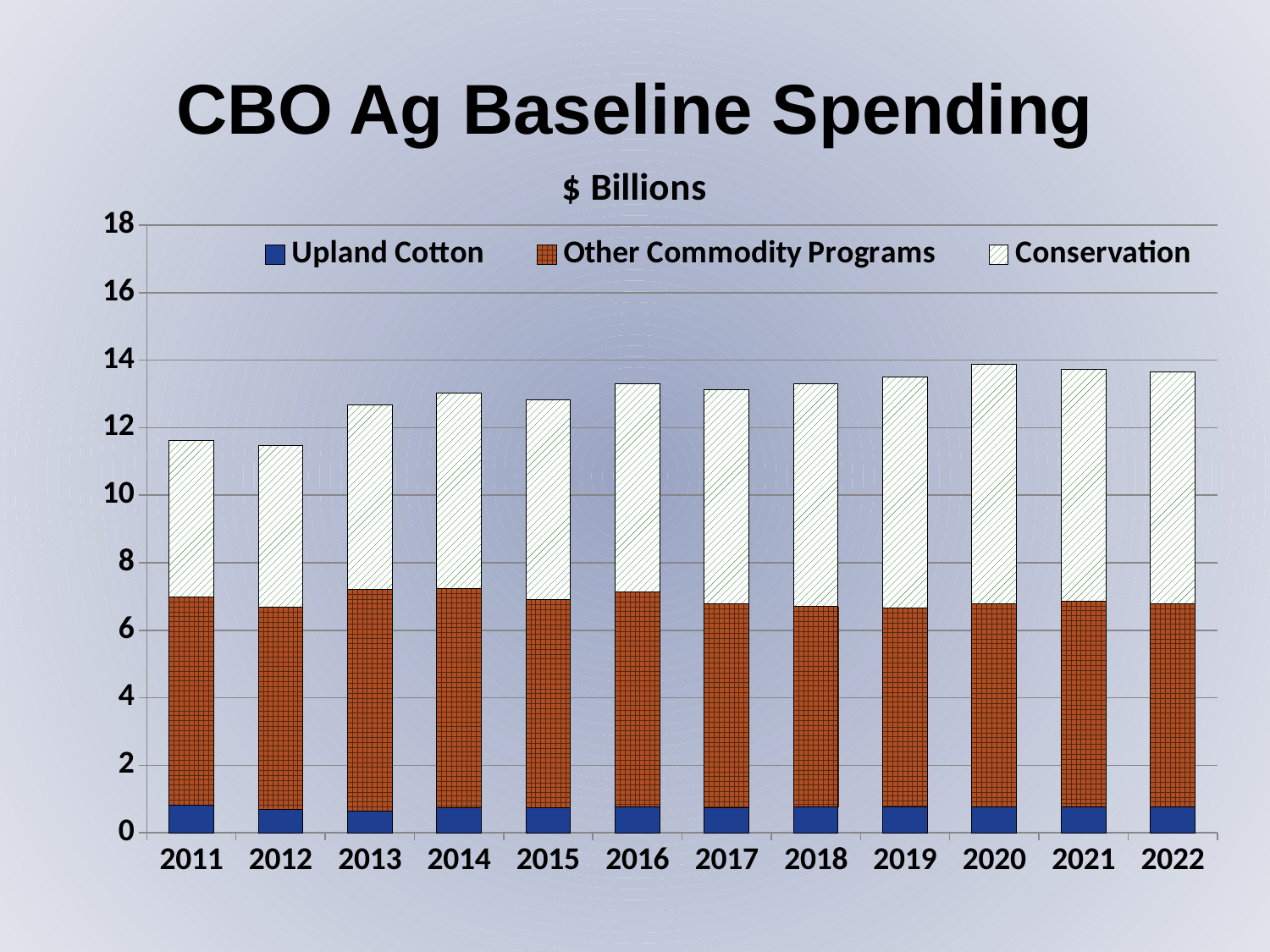
Is the Upland Cotton value for 2015 greater or less than 2? less How many years are shown on the x axis? 12 What unit is indicated above the chart? $ Billions Is the total spending for 2013 greater or less than 12? greater Which year has the larger total spending, 2012 or 2014? 2014 How many series does the legend list? 3 Is the total spending for 2016 greater or less than 14? less Does total spending generally rise or fall from 2011 to 2022? rise What is the title of the chart? CBO Ag Baseline Spending What kind of chart is shown on the slide? stacked bar chart Which year has the highest total spending? 2020